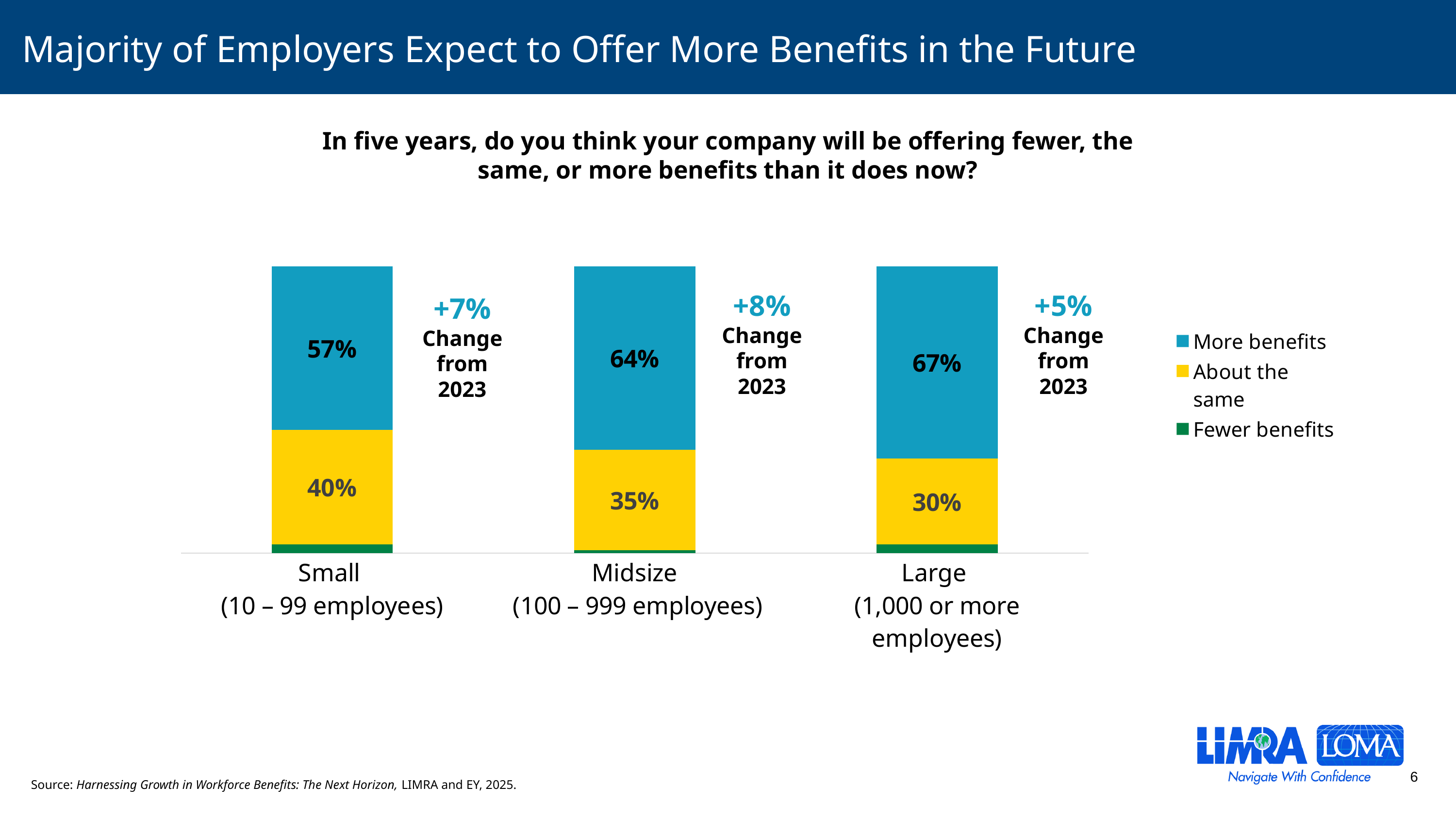
How many series does the legend list? 3 Which employer size group has the highest share expecting to offer more benefits? Large (1,000 or more employees) Which employer size group has the lowest share expecting to offer about the same benefits? Large (1,000 or more employees) Does the 'More benefits' share rise or fall moving from small to midsize to large employers? Rise What is the difference between the 'More benefits' share for large employers and for small employers? 10% What percentage of small employers (10 – 99 employees) expect to offer more benefits in five years? 57% How many employer size categories are shown on the x axis? 3 What percentage of midsize employers (100 – 999 employees) expect to offer more benefits? 64% What kind of chart is shown on the slide? Stacked bar chart What percentage of large employers (1,000 or more employees) expect to offer about the same benefits? 30% Which is larger: the 'About the same' share for small employers or for midsize employers? Small employers What is the change from 2023 shown for midsize employers? +8%